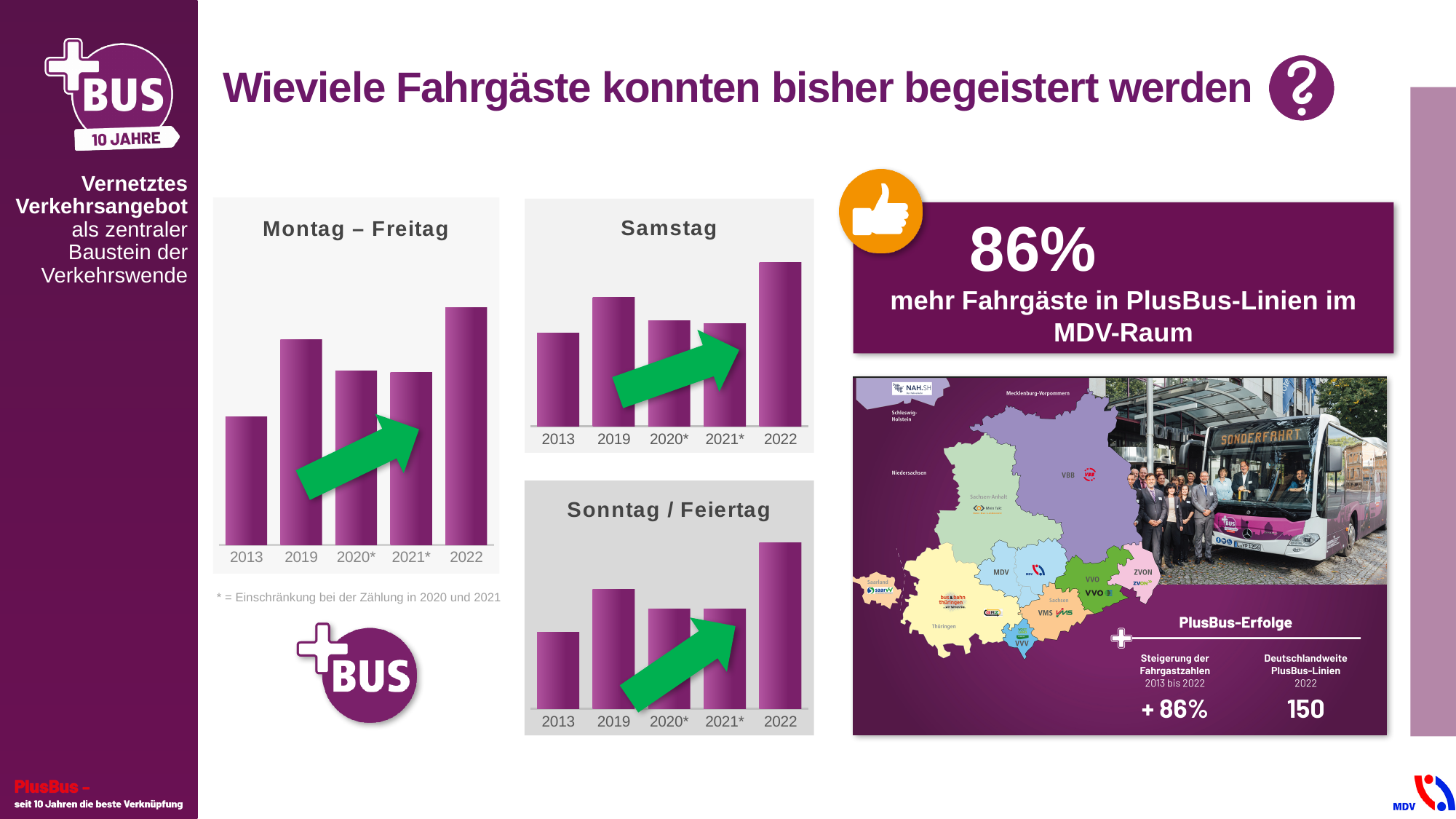
In the "Montag – Freitag" chart, which is larger, the bar for 2019 or the bar for 2020*? 2019 In the "Sonntag / Feiertag" chart, which year has the highest bar? 2022 How many bar charts are shown on the slide? 3 What kind of chart is the "Montag – Freitag" chart? bar chart In the "Samstag" chart, which year has the highest bar? 2022 In the "Samstag" chart, which year has the lowest bar? 2013 In the "Montag – Freitag" chart, which year has the lowest bar? 2013 In the "Samstag" chart, which is larger, the bar for 2019 or the bar for 2021*? 2019 According to the footnote below the "Montag – Freitag" chart, what does the asterisk on 2020* and 2021* indicate? Einschränkung bei der Zählung in 2020 und 2021 In the "Montag – Freitag" chart, which year has the highest bar? 2022 In the "Sonntag / Feiertag" chart, which is larger, the bar for 2013 or the bar for 2022? 2022 How many years are shown on the x axis of the "Samstag" chart? 5